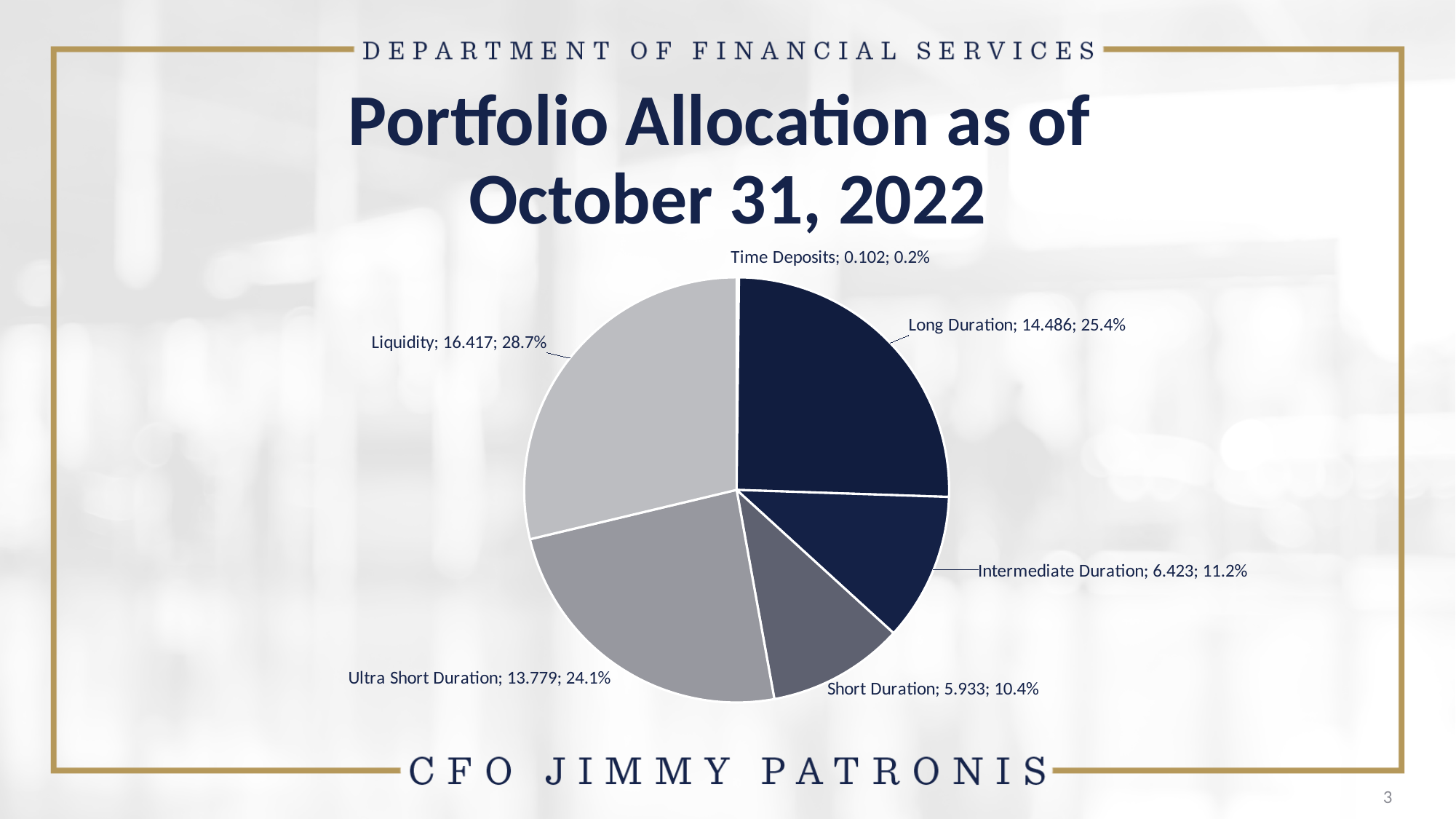
Which category has the smallest slice? Time Deposits Which is larger, Intermediate Duration or Short Duration? Intermediate Duration What kind of chart is shown on the slide? Pie chart What percentage share does Short Duration have? 10.4% How many categories are shown in the pie chart? 6 Which category has the largest slice? Liquidity What percentage share does Long Duration have? 25.4% What is the value for Liquidity? 16.417 What is the value for Intermediate Duration? 6.423 What is the value for Time Deposits? 0.102 What is the title of the chart? Portfolio Allocation as of October 31, 2022 What is the difference between the values for Long Duration and Ultra Short Duration? 0.707